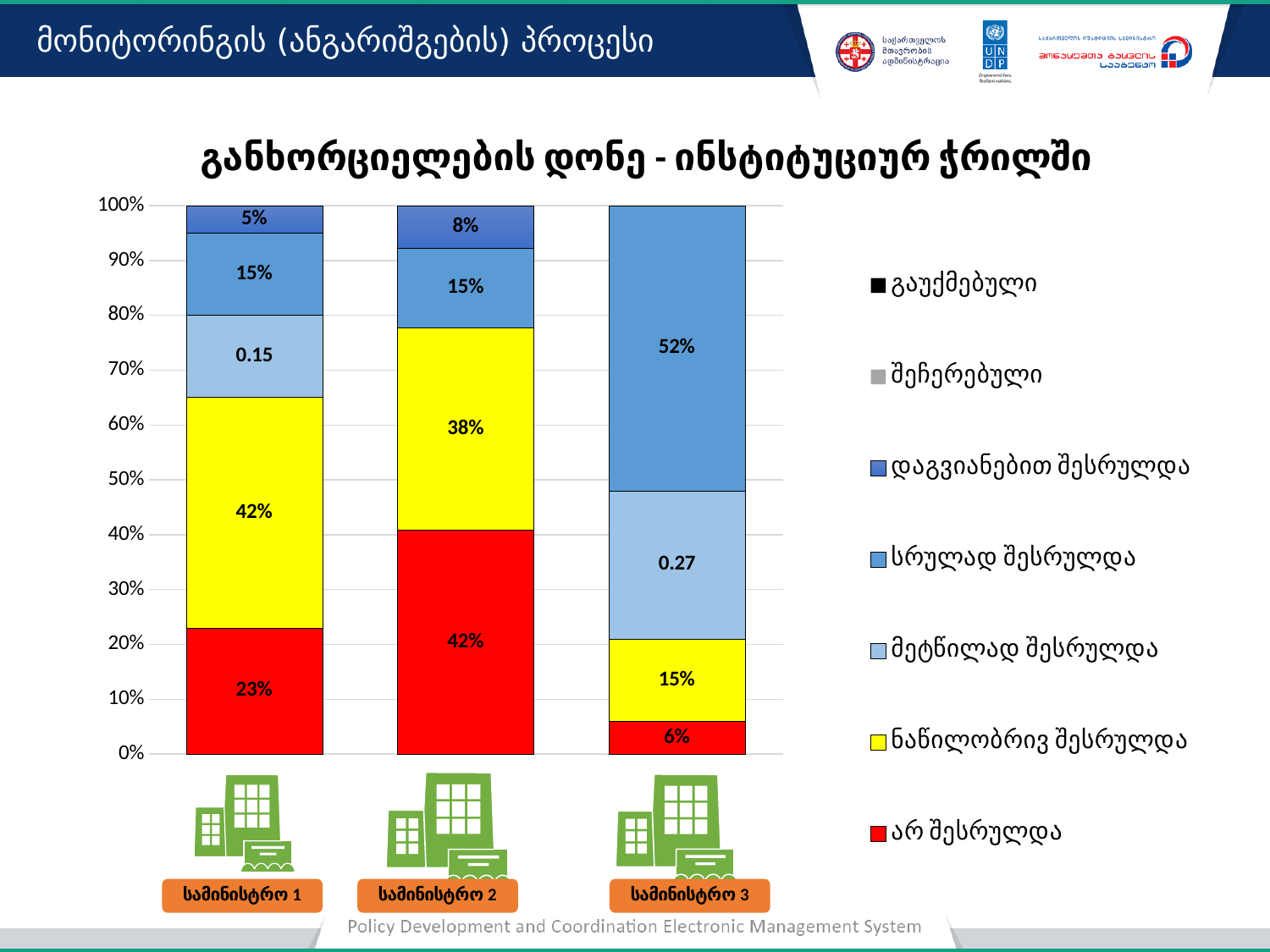
What label is printed on the მეტწილად შესრულდა segment for სამინისტრო 3? 0.27 What is the value of ნაწილობრივ შესრულდა for სამინისტრო 2? 38% How many ministries (bars) are shown in the chart? 3 What is the value of სრულად შესრულდა for სამინისტრო 3? 52% Which ministry has the lowest value for არ შესრულდა? სამინისტრო 3 What is the difference between the არ შესრულდა values for სამინისტრო 2 and სამინისტრო 1? 19% What is the value of არ შესრულდა for სამინისტრო 1? 23% Which ministry has the highest value for არ შესრულდა? სამინისტრო 2 What is the value of დაგვიანებით შესრულდა for სამინისტრო 2? 8% Which is larger: ნაწილობრივ შესრულდა for სამინისტრო 1 or for სამინისტრო 3? სამინისტრო 1 How many series does the legend list? 7 What kind of chart is shown on the slide? Stacked bar chart